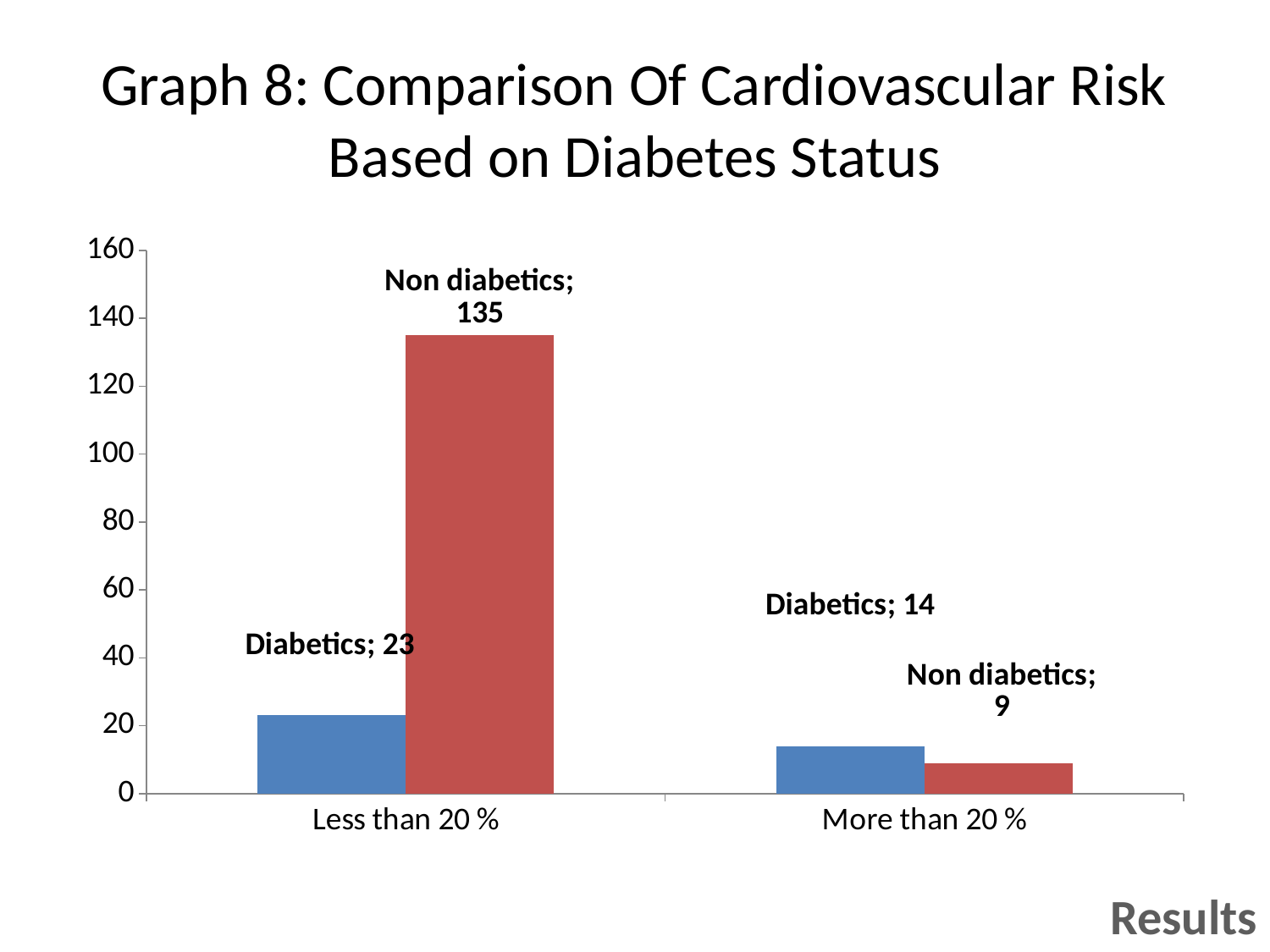
What is the value for Diabetics in the More than 20 % category? 14 What is the difference between Diabetics and Non diabetics in the More than 20 % category? 5 What is the title of the chart? Graph 8: Comparison Of Cardiovascular Risk Based on Diabetes Status What kind of chart is shown on the slide? Bar chart Which bar has the lowest value on the chart? Non diabetics, More than 20 % What is the value for Non diabetics in the Less than 20 % category? 135 What is the value for Non diabetics in the More than 20 % category? 9 What is the difference between Non diabetics and Diabetics in the Less than 20 % category? 112 In the More than 20 % category, which is larger: Diabetics or Non diabetics? Diabetics Which bar has the highest value on the chart? Non diabetics, Less than 20 % What is the value for Diabetics in the Less than 20 % category? 23 How many categories are shown on the x axis? 2